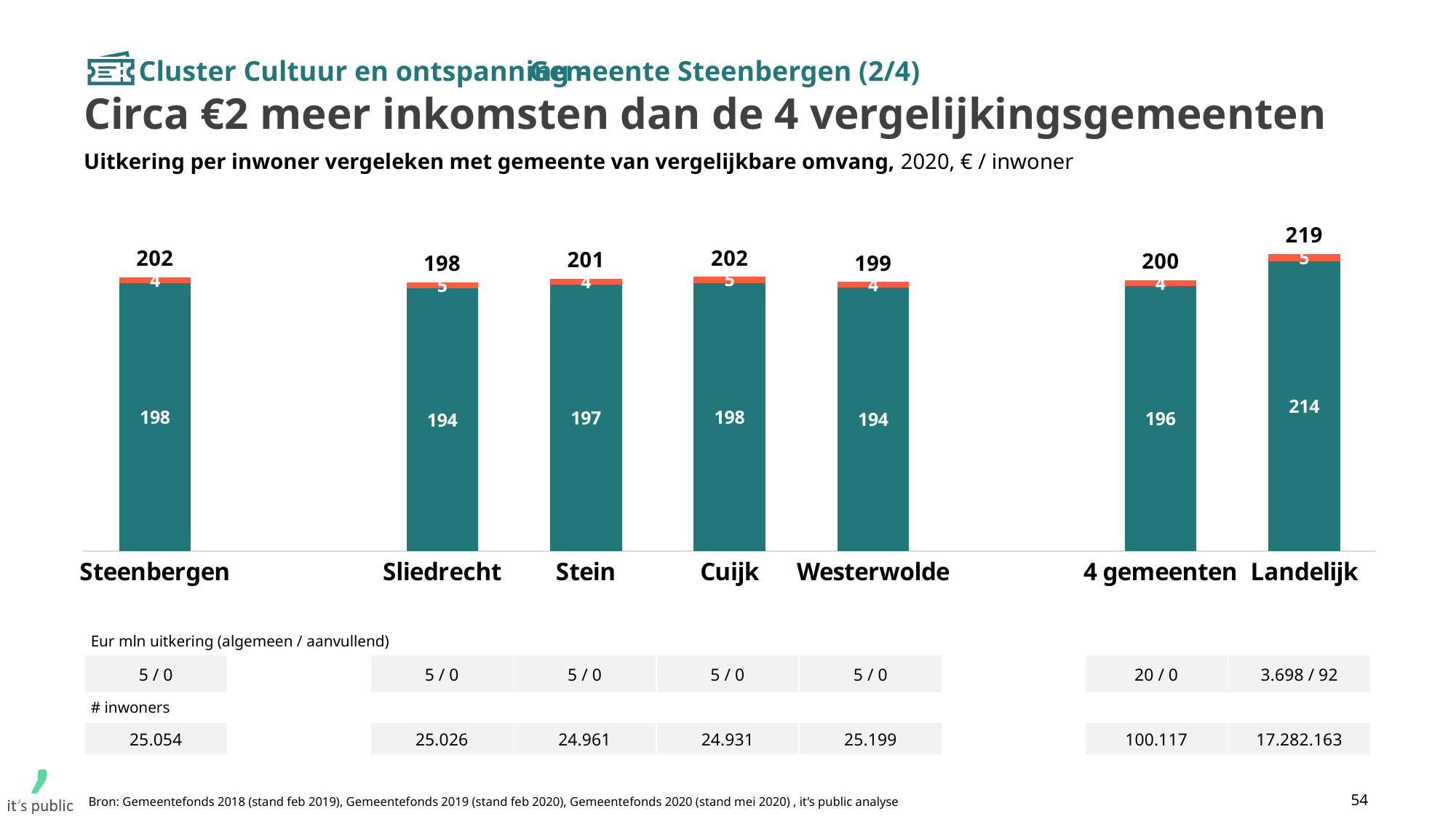
Which category has the lowest total value? Sliedrecht What is the difference between the teal segment for Stein and the teal segment for Westerwolde? 3 Which has a larger total value, Steenbergen or 4 gemeenten? Steenbergen What is the total value shown above the bar for 4 gemeenten? 200 What is the difference between the total for Landelijk and the total for Steenbergen? 17 What is the total value shown above the bar for Landelijk? 219 What is the value of the teal (lower) segment for Steenbergen? 198 How many categories are shown on the x axis of the chart? 7 What kind of chart is shown on the slide? Stacked bar chart What is the value of the orange (upper) segment for Sliedrecht? 5 Which category has the highest total value? Landelijk